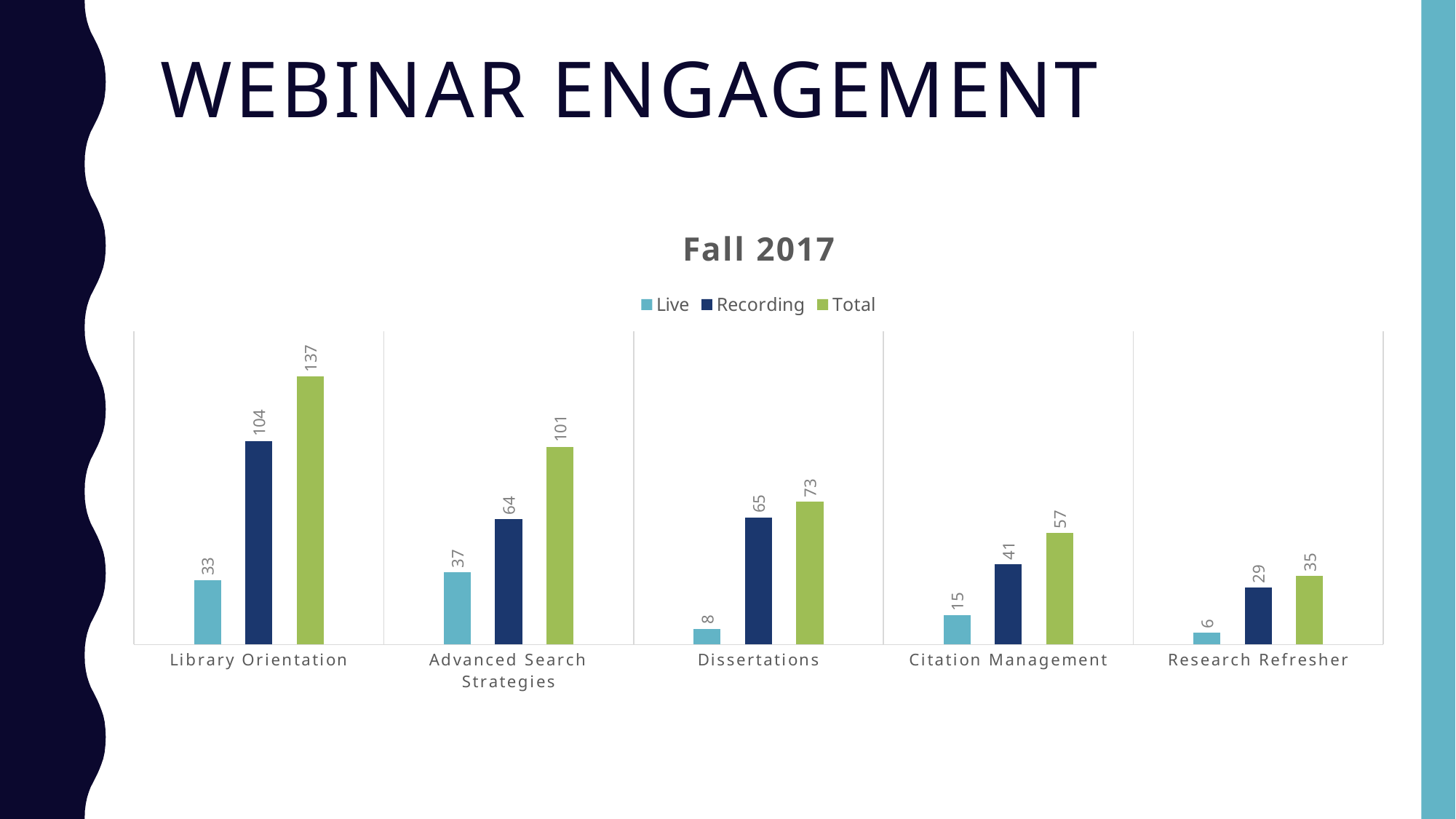
Do the Total values rise or fall from left to right across the categories? Fall How many series does the legend list? 3 What is the Total value for Library Orientation? 137 What is the Live value for Dissertations? 8 Which category has the highest Total value? Library Orientation What is the title of the chart? Fall 2017 How many categories are shown on the x axis? 5 What kind of chart is shown on the slide? Bar chart Which category has the lowest Live value? Research Refresher Which is larger: the Live value for Advanced Search Strategies or the Live value for Library Orientation? Advanced Search Strategies What is the Recording value for Citation Management? 41 What is the difference between the Recording values for Library Orientation and Advanced Search Strategies? 40